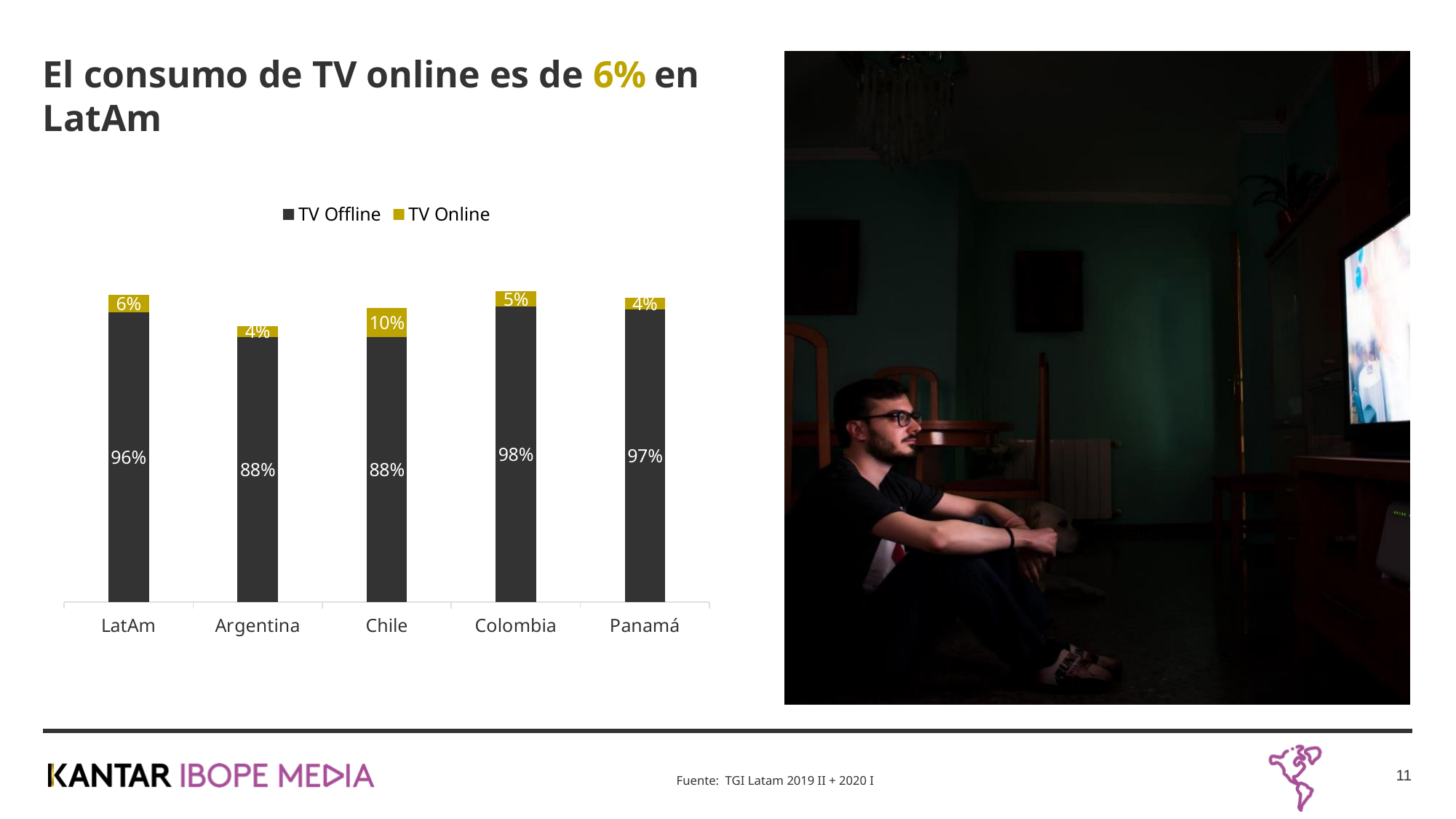
What is the TV Offline value for Argentina? 88% How many categories are shown on the x axis of the chart? 5 What kind of chart is shown on the slide? Stacked bar chart Which has a larger TV Online value, Chile or Colombia? Chile Which category has the highest TV Offline value? Colombia What is the TV Offline value for Panamá? 97% How many series does the legend list? 2 Which category has the highest TV Online value? Chile What is the TV Online value for LatAm? 6% What are the two series named in the chart legend? TV Offline and TV Online What is the TV Online value for Chile? 10% What is the difference between the TV Offline values for Colombia and Argentina? 10 percentage points